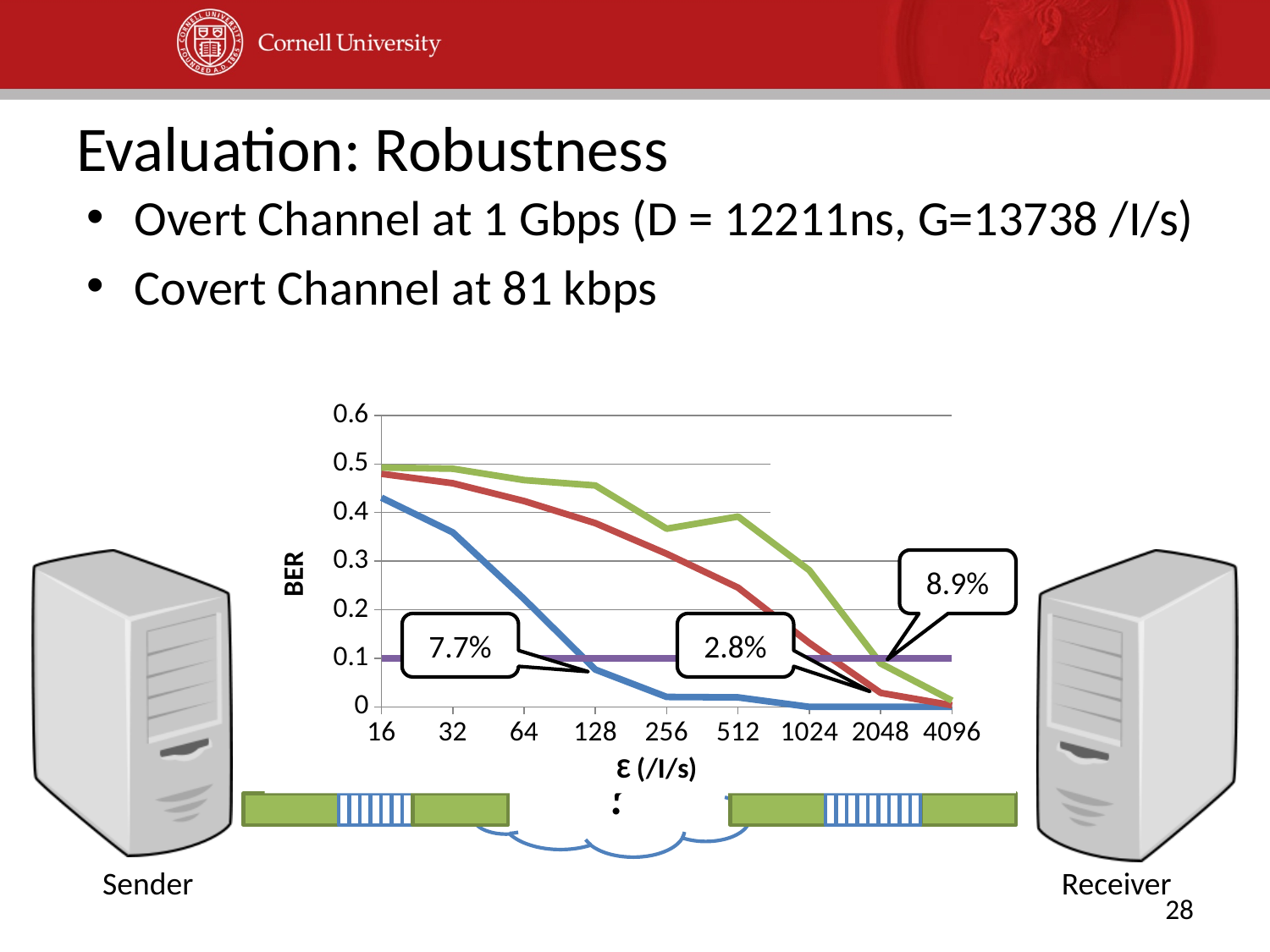
Is the BER value of the red line at ε = 4096 greater or less than 0.1? less What percentage does the callout pointing to the green line near ε = 2048 show? 8.9% Do the blue, red and green lines rise or fall as ε increases along the x axis? fall How many tick values are labelled along the x axis of the chart? 9 What is the label of the y axis of the chart? BER Is the BER value of the blue line at ε = 128 greater or less than 0.1? less Is the BER value of the blue line at ε = 16 greater or less than 0.4? greater What kind of chart is shown on the slide? line chart What is the label of the x axis of the chart? ε (/I/s) What percentage does the callout pointing to the blue line near ε = 128 show? 7.7% At ε = 1024, which line has the higher BER, the green line or the blue line? green